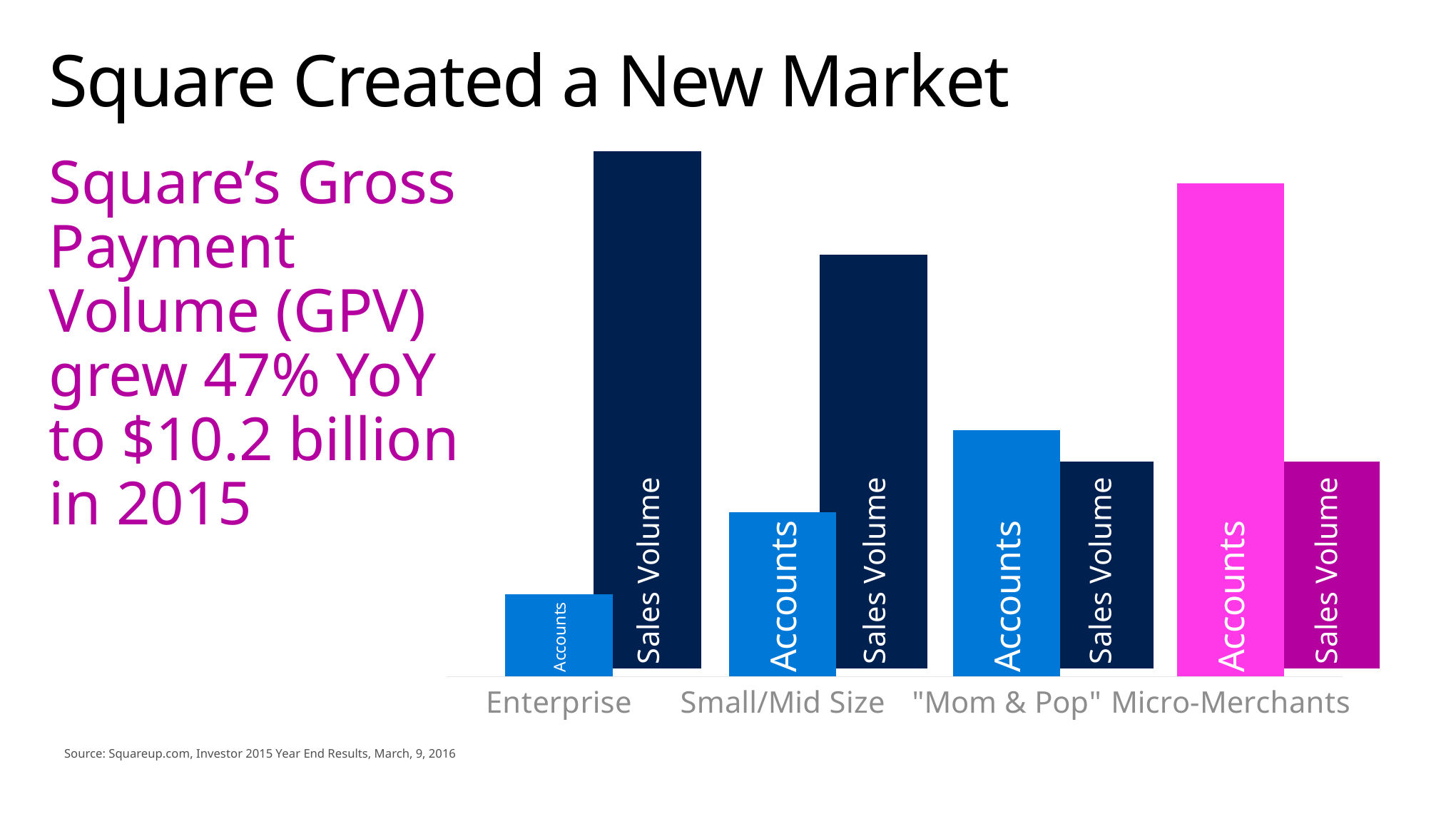
For Micro-Merchants, which bar is taller: Accounts or Sales Volume? Accounts What kind of chart is shown on the slide? bar chart Which category has the highest Accounts bar? Micro-Merchants Do the Sales Volume bars generally rise or fall moving from Enterprise to Micro-Merchants along the x axis? fall For Enterprise, which bar is taller: Accounts or Sales Volume? Sales Volume Which category has the highest Sales Volume bar? Enterprise Which category has the lowest Accounts bar? Enterprise Which is larger: the Sales Volume bar for Small/Mid Size or the Sales Volume bar for "Mom & Pop"? Small/Mid Size Do the Accounts bars rise or fall moving from Enterprise to Micro-Merchants along the x axis? rise How many data series (bar types) are shown for each category in the chart? 2 How many merchant categories are shown along the x axis of the chart? 4 What are the two series labels printed on the bars in the chart? Accounts and Sales Volume